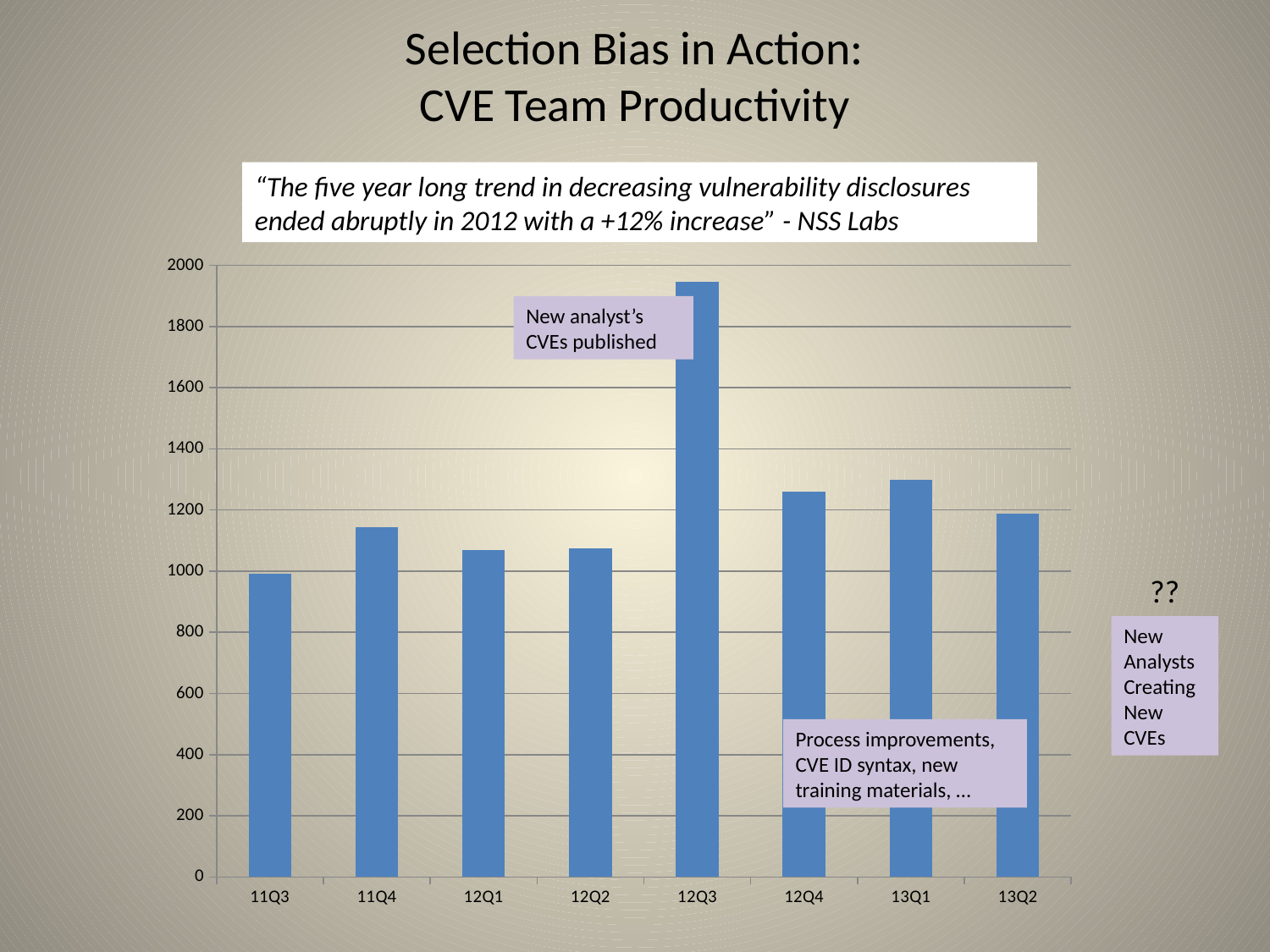
Is the value for 12Q3 greater or less than 1800? greater What kind of chart is shown on the slide? bar chart Which quarter has the highest value? 12Q3 Which quarter has the lowest value? 11Q3 Is the value for 12Q2 greater or less than 1000? greater Is the value for 13Q1 greater or less than 1200? greater How many quarters are plotted on the x axis? 8 According to the annotation on the chart, what explains the spike in 12Q3? New analyst's CVEs published Which is larger, the value for 13Q1 or the value for 13Q2? 13Q1 Which is larger, the value for 11Q4 or the value for 12Q1? 11Q4